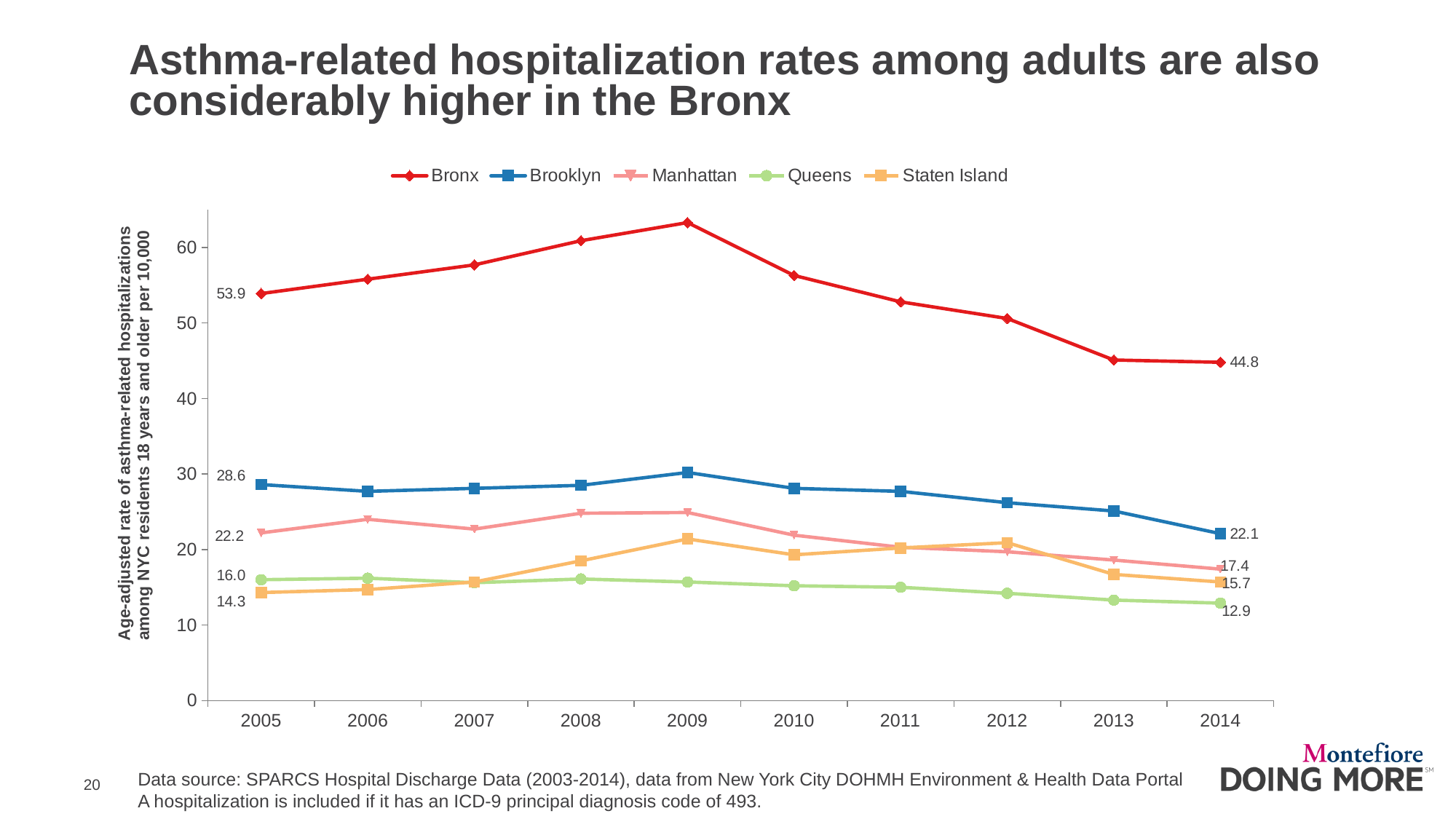
What kind of chart is shown on the slide? Line chart Which is larger in 2014, the value for Manhattan or the value for Staten Island? Manhattan Is the value for the Bronx in 2009 greater or less than 60? greater Which borough has the lowest value in 2005? Staten Island Which borough has the highest value in 2014? Bronx What is the value for Staten Island in 2005? 14.3 By how much did the Bronx value fall from 2005 to 2014? 9.1 What is the value for Queens in 2014? 12.9 What is the value for the Bronx in 2005? 53.9 How many years are shown on the x axis? 10 How many series does the legend list? 5 What is the value for Brooklyn in 2014? 22.1